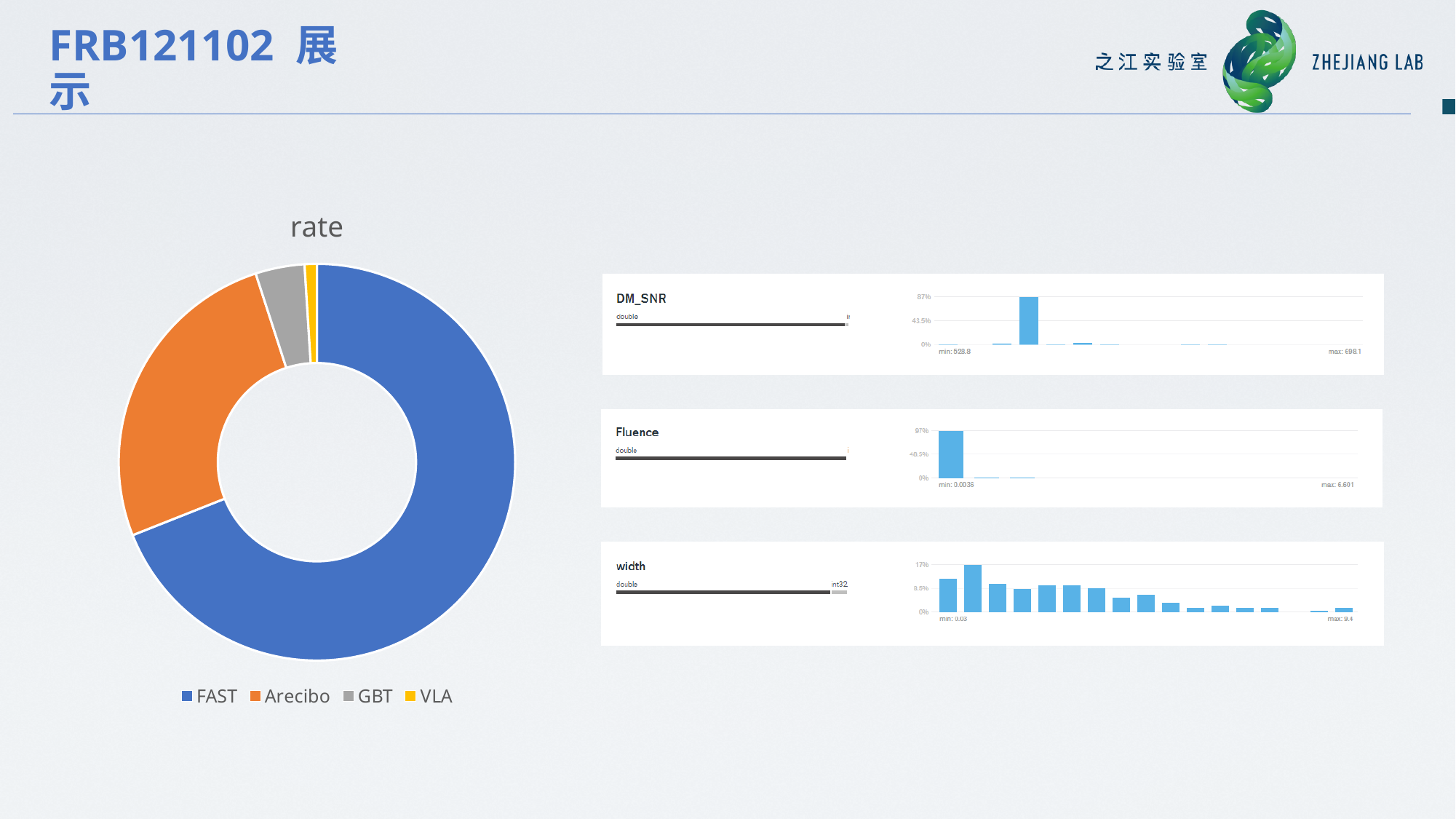
In the width histogram, is the tallest bar greater or less than 8.5%? greater What maximum value is printed under the width histogram? max: 9.4 What is the title of the doughnut chart on the left of the slide? rate In the "rate" chart, which category has the smallest share? VLA How many categories does the legend of the "rate" chart list? 4 What kind of chart is the chart titled "rate"? doughnut chart In the "rate" chart, which has the larger share, FAST or Arecibo? FAST In the DM_SNR histogram, is the tallest bar greater or less than 43.5%? greater In the "rate" chart, which category has the largest share? FAST In the Fluence histogram, is the tallest bar greater or less than 48.5%? greater In the "rate" chart, which has the larger share, Arecibo or GBT? Arecibo What colour represents Arecibo in the "rate" chart? orange